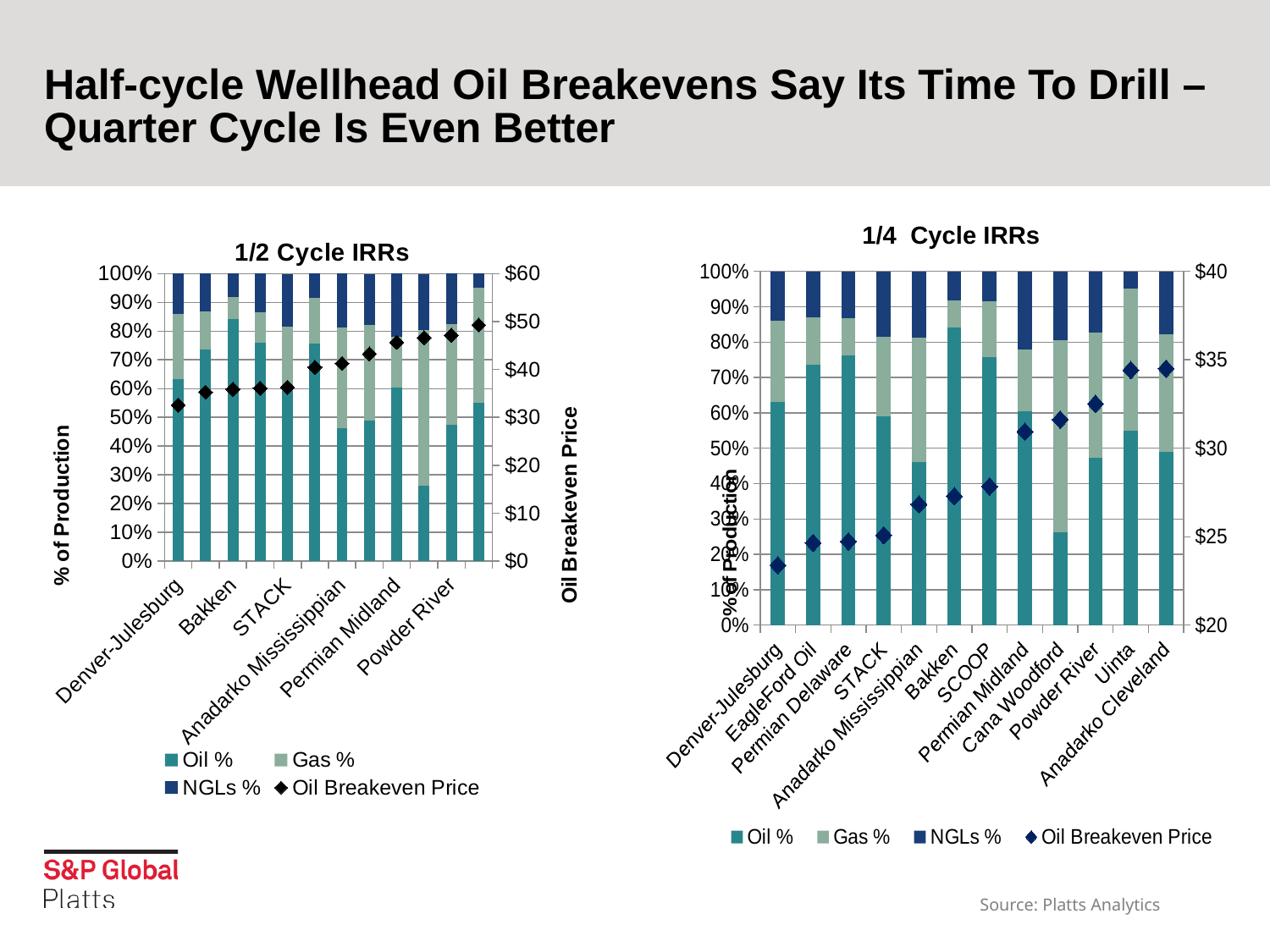
In the "1/4 Cycle IRRs" chart, is the Oil % for Bakken greater or less than 80%? greater How many categories are shown on the x axis of the "1/4 Cycle IRRs" chart? 12 In the "1/4 Cycle IRRs" chart, is the Oil % for Cana Woodford greater or less than 30%? less In the "1/4 Cycle IRRs" chart, is the Oil Breakeven Price for Denver-Julesburg greater or less than $25? less How many series does the legend of the "1/2 Cycle IRRs" chart list? 4 What kind of chart is the "1/4 Cycle IRRs" chart? Bar chart with a line/marker series (stacked bar chart) In the "1/4 Cycle IRRs" chart, which category has the highest Oil %? Bakken What is the label of the right-hand vertical axis on the "1/2 Cycle IRRs" chart? Oil Breakeven Price In the "1/4 Cycle IRRs" chart, does the Oil Breakeven Price rise or fall moving from left to right along the x axis? rise In the "1/4 Cycle IRRs" chart, which category has the lowest Oil Breakeven Price? Denver-Julesburg